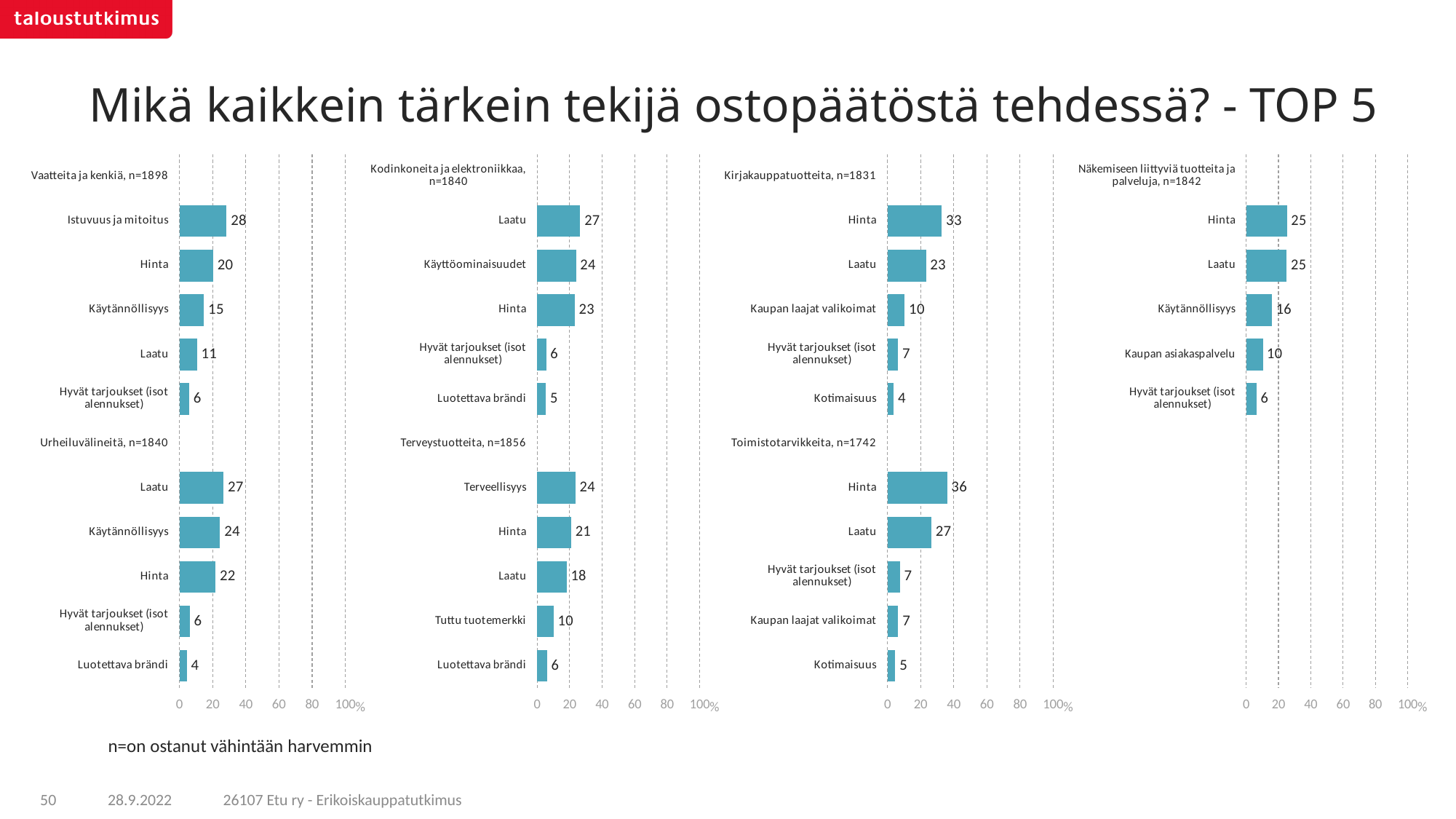
In the Kodinkoneita ja elektroniikkaa group, what is the difference between Laatu and Luotettava brändi? 22 In the Toimistotarvikkeita group, what is the value for Hinta? 36 In the Vaatteita ja kenkiä group, what is the value for Istuvuus ja mitoitus? 28 In the Näkemiseen liittyviä tuotteita ja palveluja group, what is the value for Käytännöllisyys? 16 In the Kirjakauppatuotteita group, which factor has the lowest value? Kotimaisuus In the Urheiluvälineitä group, which is larger: Laatu or Hinta? Laatu What is the sample size (n) shown for the Toimistotarvikkeita group? n=1742 What type of chart is used on this slide? bar chart In the Terveystuotteita group, what is the value for Tuttu tuotemerkki? 10 How many factors are shown in the Toimistotarvikkeita group? 5 In the Kirjakauppatuotteita group, is the value for Hinta greater or less than 20? greater In the Terveystuotteita group, which factor has the highest value? Terveellisyys